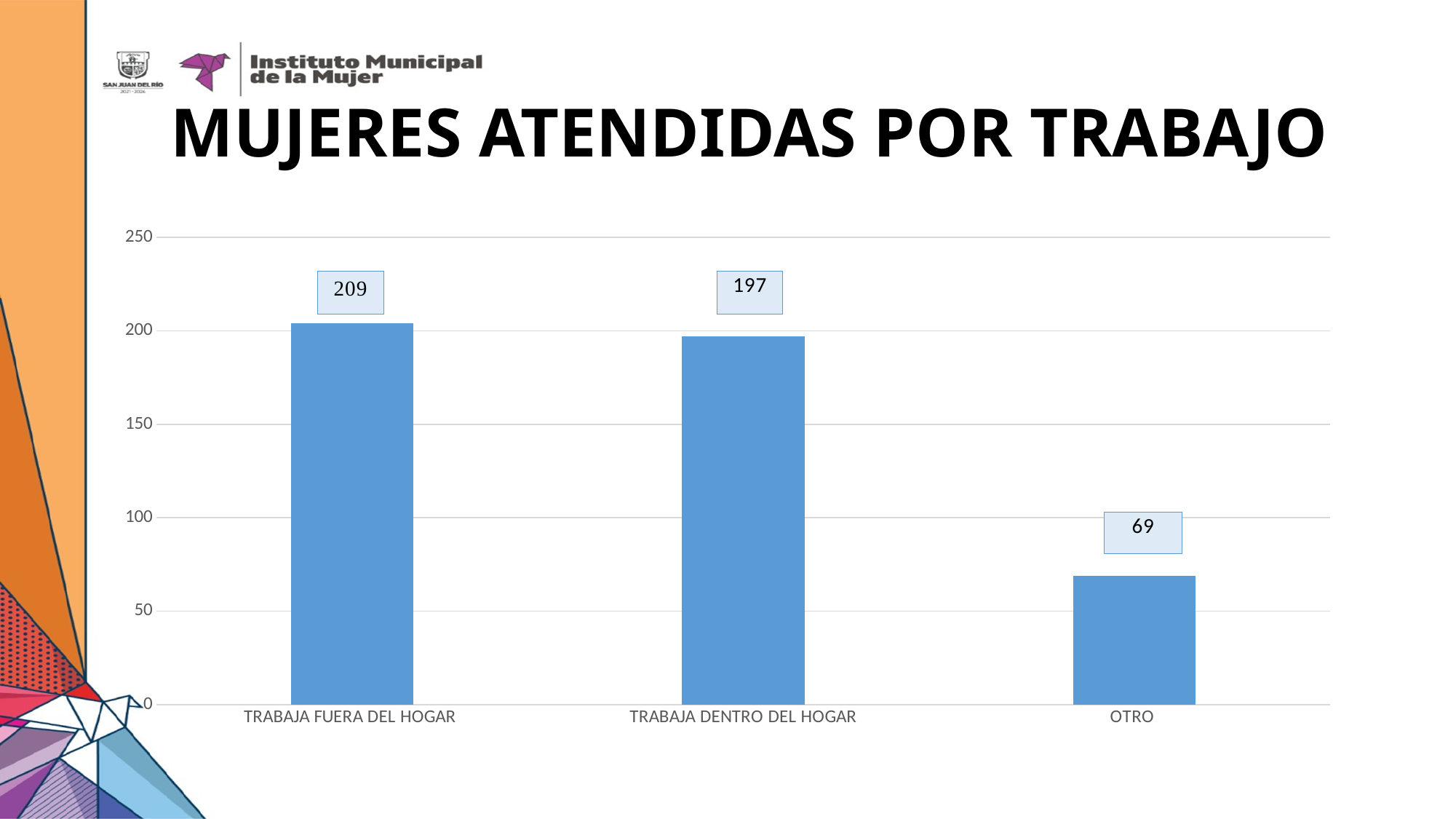
What is the difference between the values for TRABAJA FUERA DEL HOGAR and TRABAJA DENTRO DEL HOGAR? 12 What is the value for TRABAJA FUERA DEL HOGAR? 209 What is the value for TRABAJA DENTRO DEL HOGAR? 197 Which is larger, the value for TRABAJA DENTRO DEL HOGAR or the value for OTRO? TRABAJA DENTRO DEL HOGAR What kind of chart is shown on the slide? bar chart Is the value for OTRO greater or less than 100? less What is the value for OTRO? 69 Which category has the highest value? TRABAJA FUERA DEL HOGAR How many categories are shown on the x axis? 3 Which category has the lowest value? OTRO What is the title of the slide? MUJERES ATENDIDAS POR TRABAJO What is the difference between the values for TRABAJA FUERA DEL HOGAR and OTRO? 140